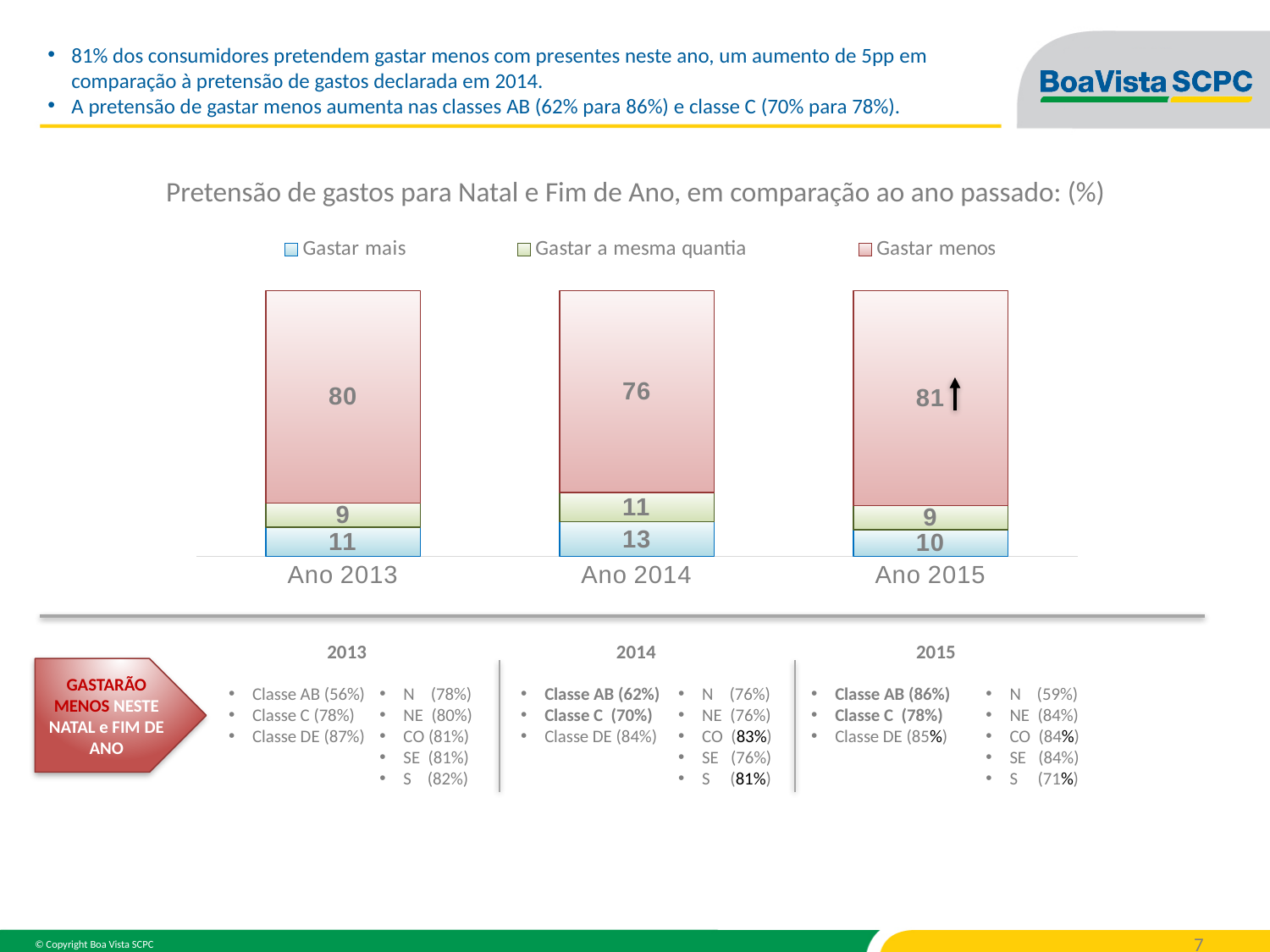
What is the total of the stacked bar for Ano 2014? 100 What is the value for "Gastar a mesma quantia" in Ano 2015? 9 What is the difference between the "Gastar menos" values for Ano 2015 and Ano 2014? 5 Which year has the lowest value for "Gastar mais"? Ano 2015 How many series does the chart legend list? 3 How many years are shown on the x axis of the chart? 3 What kind of chart is shown on the slide? Stacked bar chart Which year has the highest value for "Gastar menos"? Ano 2015 What is the title of the chart? Pretensão de gastos para Natal e Fim de Ano, em comparação ao ano passado: (%) Which is larger: "Gastar a mesma quantia" in Ano 2014 or in Ano 2013? Ano 2014 What is the value for "Gastar menos" in Ano 2014? 76 What is the value for "Gastar mais" in Ano 2013? 11